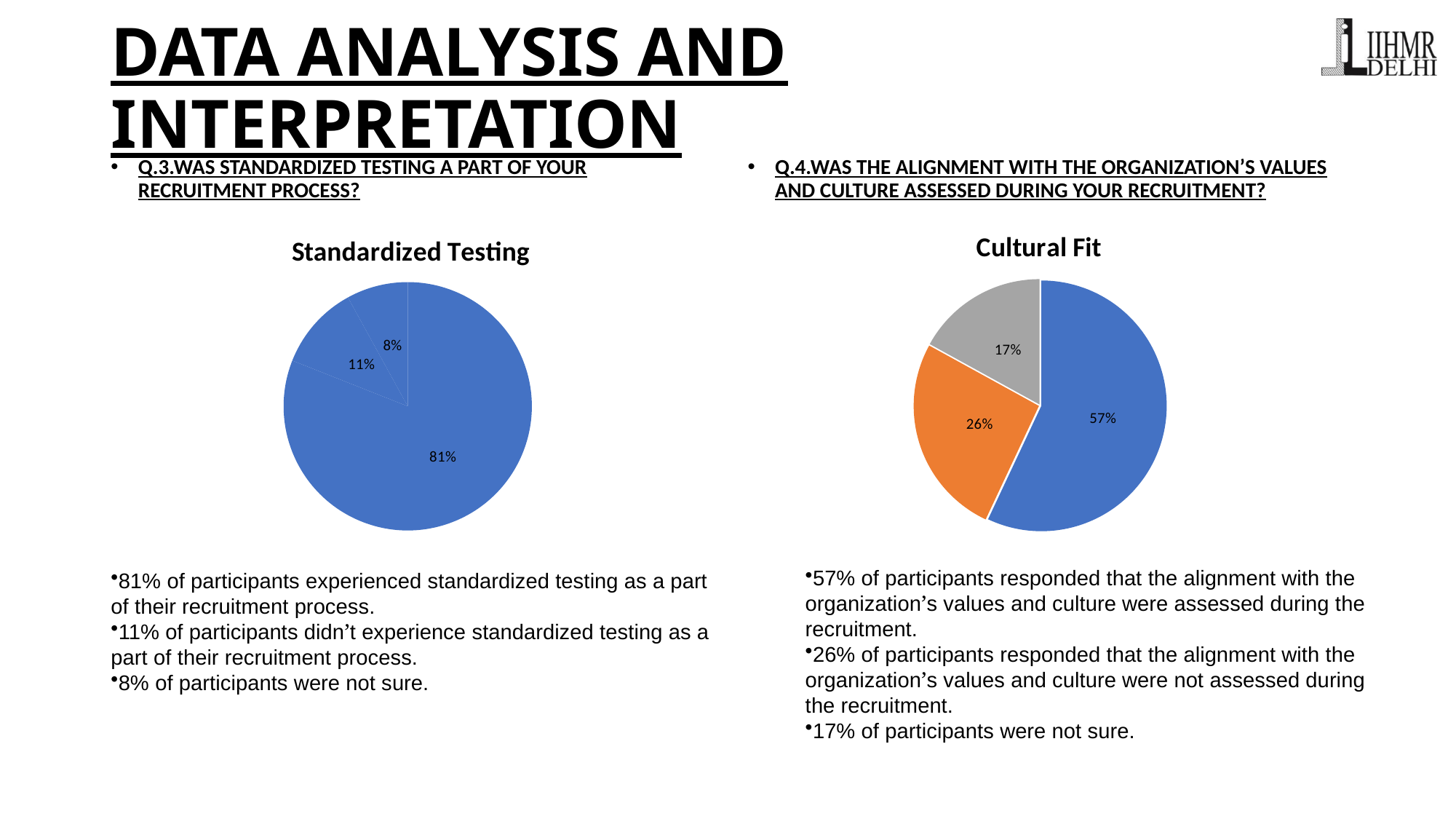
In the "Cultural Fit" chart, what share does the blue slice represent? 57% In the "Cultural Fit" chart, what share does the orange slice represent? 26% What kind of chart is the "Standardized Testing" chart? pie chart In the "Standardized Testing" chart, what is the share of the largest slice? 81% Which chart has the larger largest slice, "Standardized Testing" or "Cultural Fit"? Standardized Testing In the "Standardized Testing" chart, what is the difference in percentage points between the 11% slice and the 8% slice? 3 How many slices does the "Standardized Testing" pie chart have? 3 In the "Standardized Testing" chart, what is the share of the smallest slice? 8% In the "Cultural Fit" chart, what share does the grey slice represent? 17% How many slices does the "Cultural Fit" pie chart have? 3 What kind of chart is the "Cultural Fit" chart? pie chart In the "Cultural Fit" chart, what is the difference in percentage points between the blue slice and the orange slice? 31